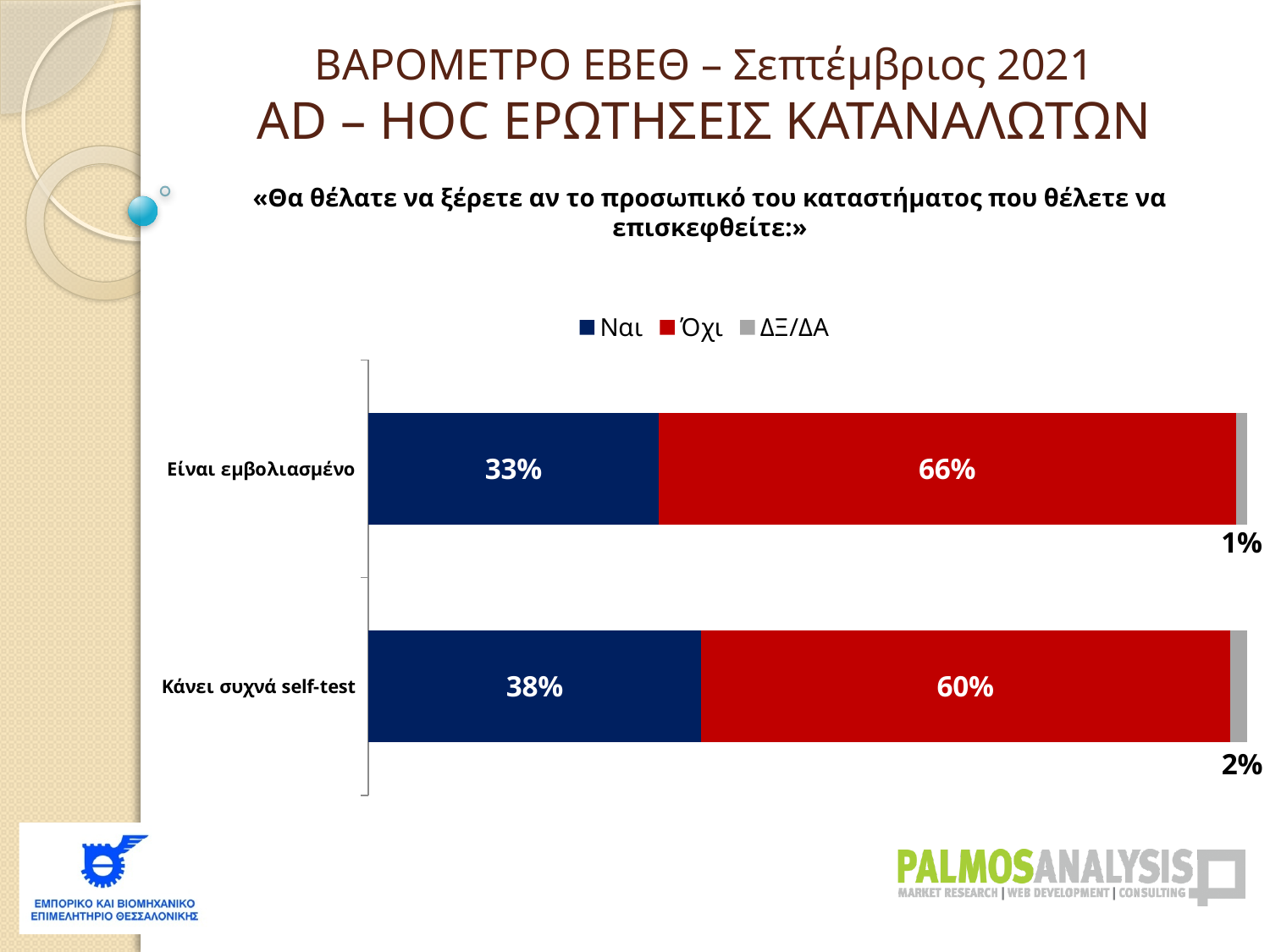
What is the value for ΔΞ/ΔΑ for Κάνει συχνά self-test? 2% How many categories are shown on the chart? 2 Which colour represents Όχι in the chart? Red Is the Ναι value larger for Είναι εμβολιασμένο or for Κάνει συχνά self-test? Κάνει συχνά self-test Which category has the higher Ναι value? Κάνει συχνά self-test What is the difference between the Όχι values for Είναι εμβολιασμένο and Κάνει συχνά self-test? 6% Which category has the lower Όχι value? Κάνει συχνά self-test What is the value for Όχι for Κάνει συχνά self-test? 60% How many series does the legend list? 3 What kind of chart is shown on the slide? Stacked bar chart What is the value for Ναι for Είναι εμβολιασμένο? 33% What is the value for ΔΞ/ΔΑ for Είναι εμβολιασμένο? 1%